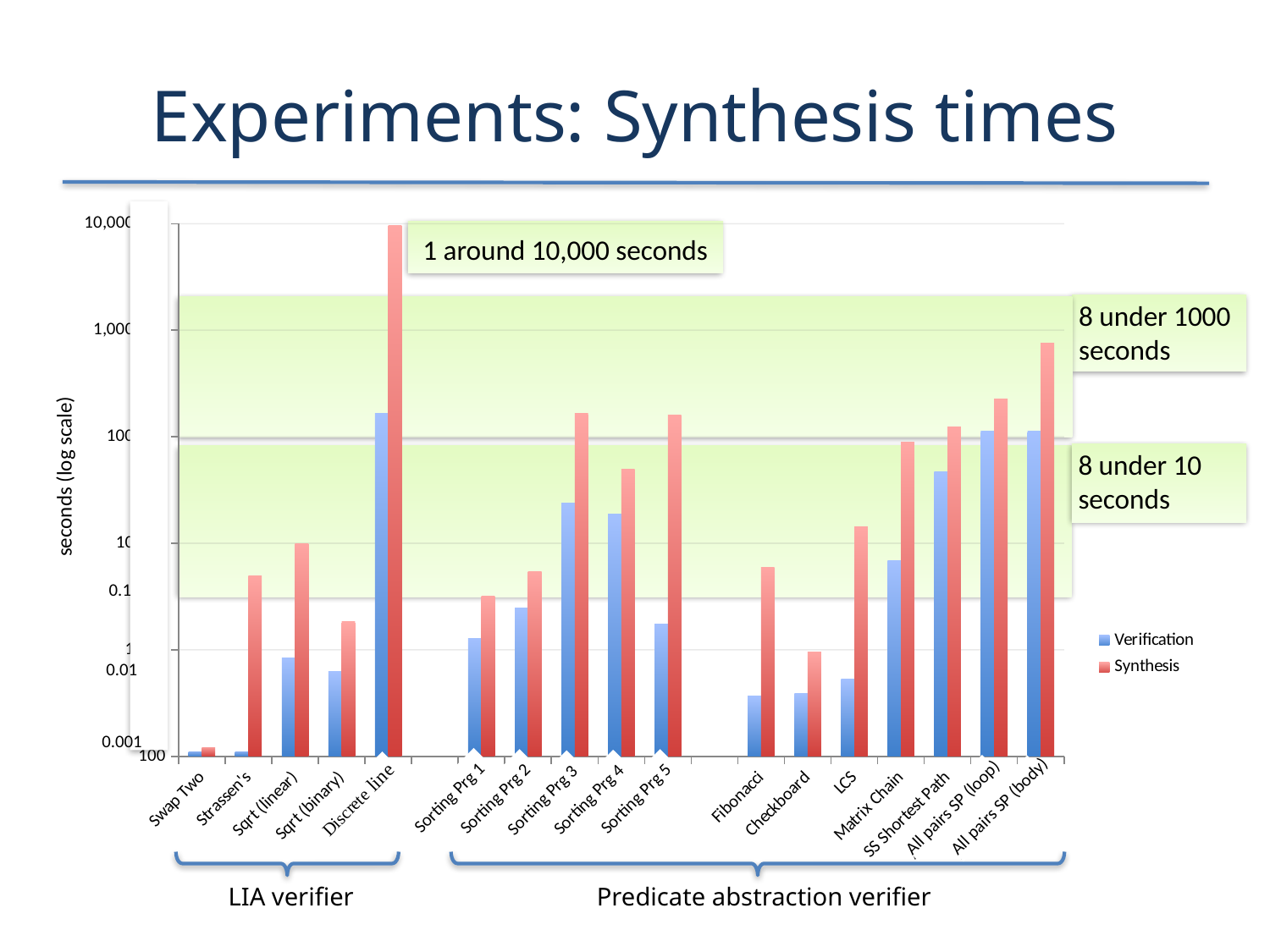
Which has the larger Verification time: Sorting Prg 1 or Sorting Prg 3? Sorting Prg 3 For Sorting Prg 3, which is larger: the Verification time or the Synthesis time? Synthesis What is the title of the slide? Experiments: Synthesis times How many program categories are shown along the x axis? 17 Which has the larger Synthesis time: Fibonacci or LCS? LCS Which series is shown in red in the legend? Synthesis Which category has the highest Verification time? Discrete line How many series does the legend list? 2 Which category has the lowest Synthesis time? Swap Two What kind of chart is shown on the slide? bar chart Which category has the highest Synthesis time? Discrete line